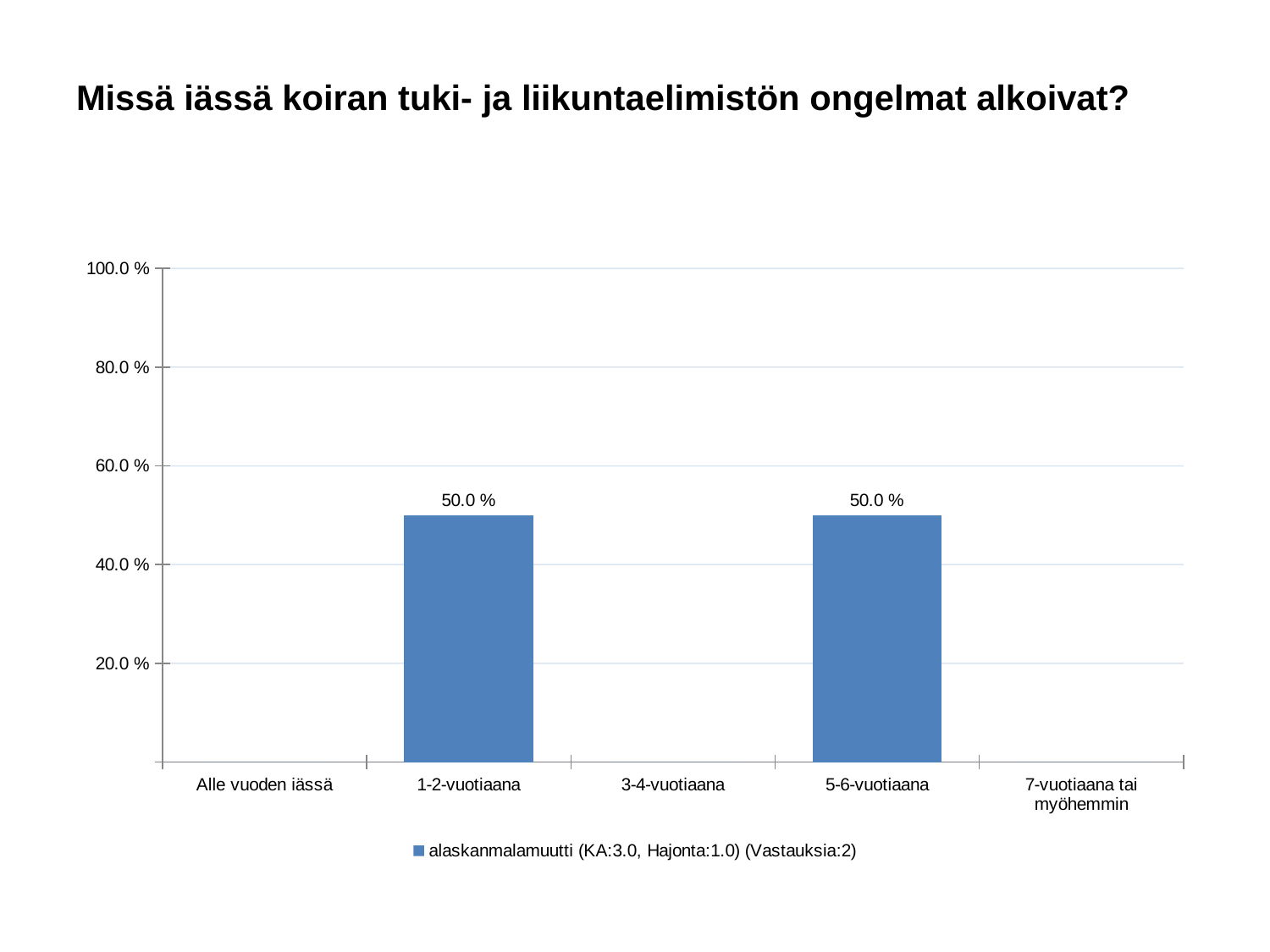
How many series does the legend list? 1 What is the value for 5-6-vuotiaana? 50.0 % What series name does the legend show? alaskanmalamuutti (KA:3.0, Hajonta:1.0) (Vastauksia:2) What kind of chart is shown on the slide? bar chart What is the title of the chart? Missä iässä koiran tuki- ja liikuntaelimistön ongelmat alkoivat? How many categories are shown on the x axis? 5 What is the value for 1-2-vuotiaana? 50.0 % What is the difference between the values for 1-2-vuotiaana and 5-6-vuotiaana? 0.0 % What is the total of the values for 1-2-vuotiaana and 5-6-vuotiaana? 100.0 % Is the value for 5-6-vuotiaana greater or less than 40.0 %? greater Is the value for 1-2-vuotiaana greater or less than 60.0 %? less How many categories have a visible bar? 2